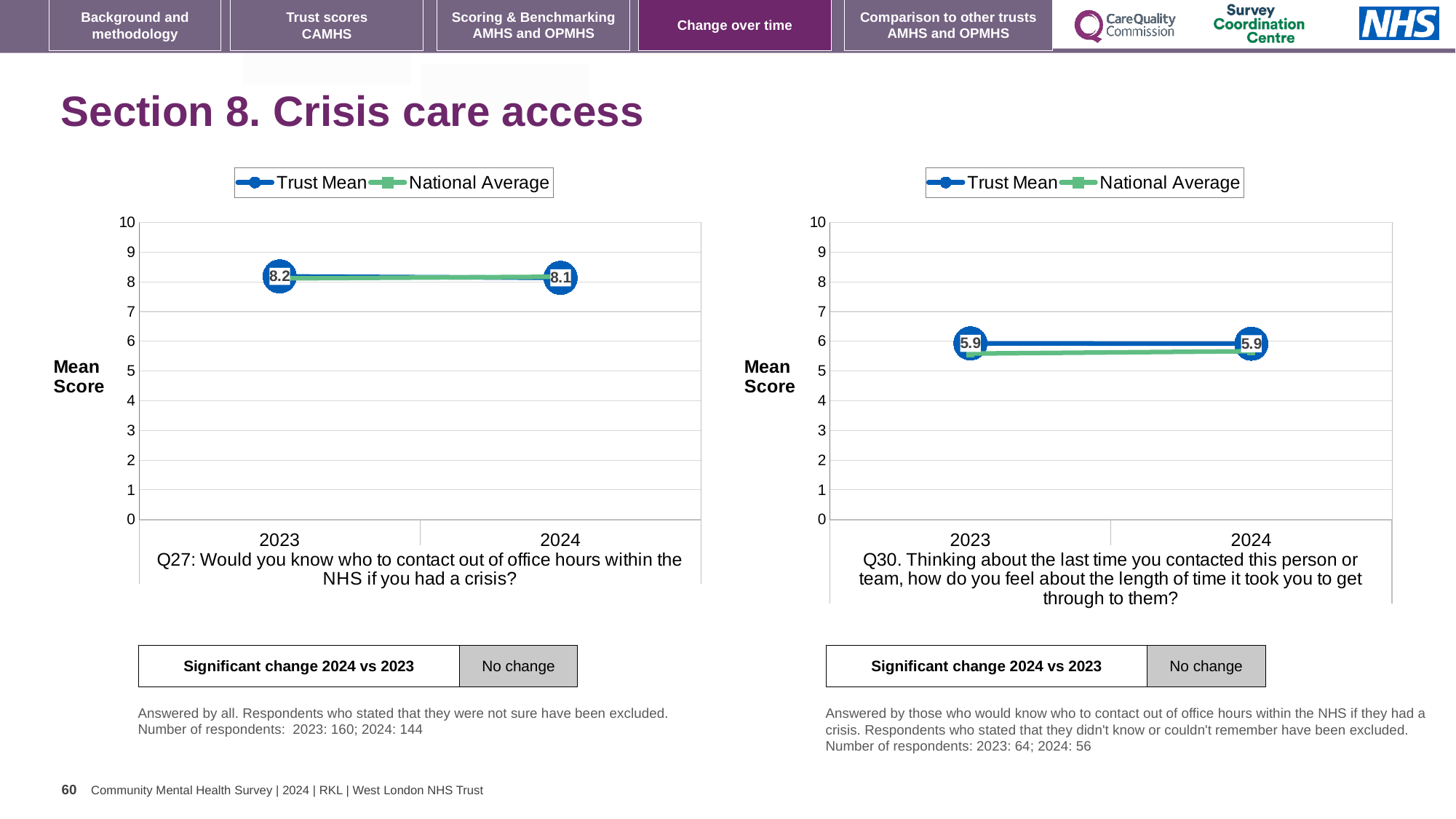
On the right chart (Q30), does the Trust Mean rise, fall or stay the same from 2023 to 2024? stays the same How many series does the legend of the right chart (Q30) list? 2 On the left chart (Q27), what is the Trust Mean score for 2024? 8.1 What is the label on the y axis of both charts? Mean Score On the left chart (Q27), what is the Trust Mean score for 2023? 8.2 On the right chart (Q30), what is the Trust Mean score for 2024? 5.9 How many years are plotted on the x axis of the left chart (Q27)? 2 On the left chart (Q27), by how much did the Trust Mean change from 2023 to 2024? 0.1 On the left chart (Q27), does the Trust Mean rise or fall from 2023 to 2024? fall What kind of chart is the left chart (Q27)? line chart On the right chart (Q30), is the National Average value for 2023 greater or less than 5? greater On the right chart (Q30), which is larger in 2023, the Trust Mean or the National Average? Trust Mean